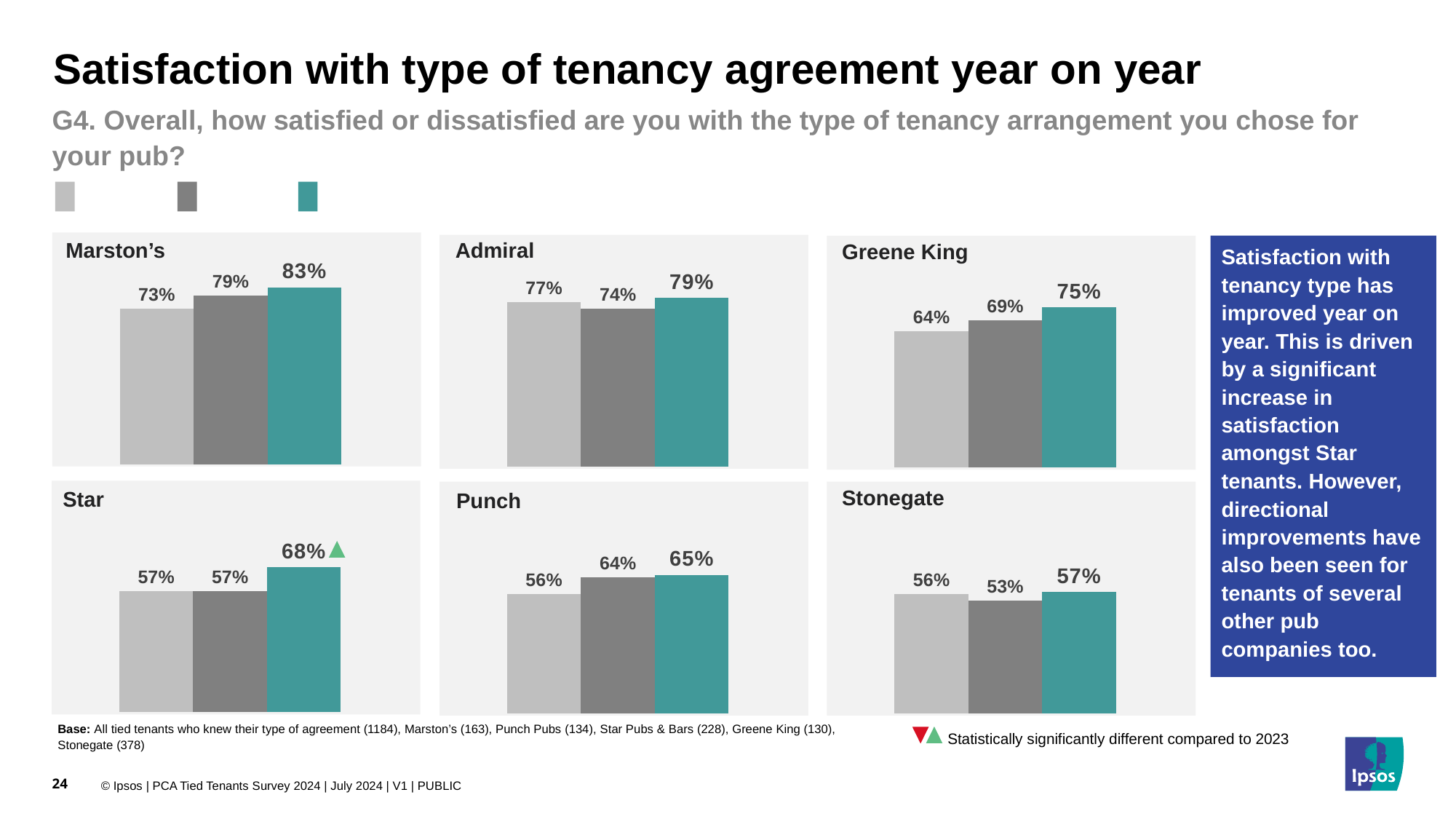
In the Greene King chart, do the values rise or fall from the first bar to the third bar? Rise In the Admiral chart, what value is shown for the dark grey (second) bar? 74% In the Greene King chart, what is the difference between the teal (third) bar and the light grey (first) bar? 11 percentage points How many bars are shown in the Punch chart? 3 In the Marston's chart, which bar has the highest value? The teal (third) bar, 83% What type of chart is used for Marston's? Bar chart In the Stonegate chart, which bar has the lowest value? The dark grey (second) bar, 53% In the Greene King chart, what value is shown for the light grey (first) bar? 64% In the Star chart, what is the difference between the teal (third) bar and the dark grey (second) bar? 11 percentage points In the Marston's chart, what value is shown for the teal (third) bar? 83% In the Admiral chart, which is larger: the light grey (first) bar or the dark grey (second) bar? The light grey (first) bar, 77% In the Stonegate chart, what value is shown for the teal (third) bar? 57%